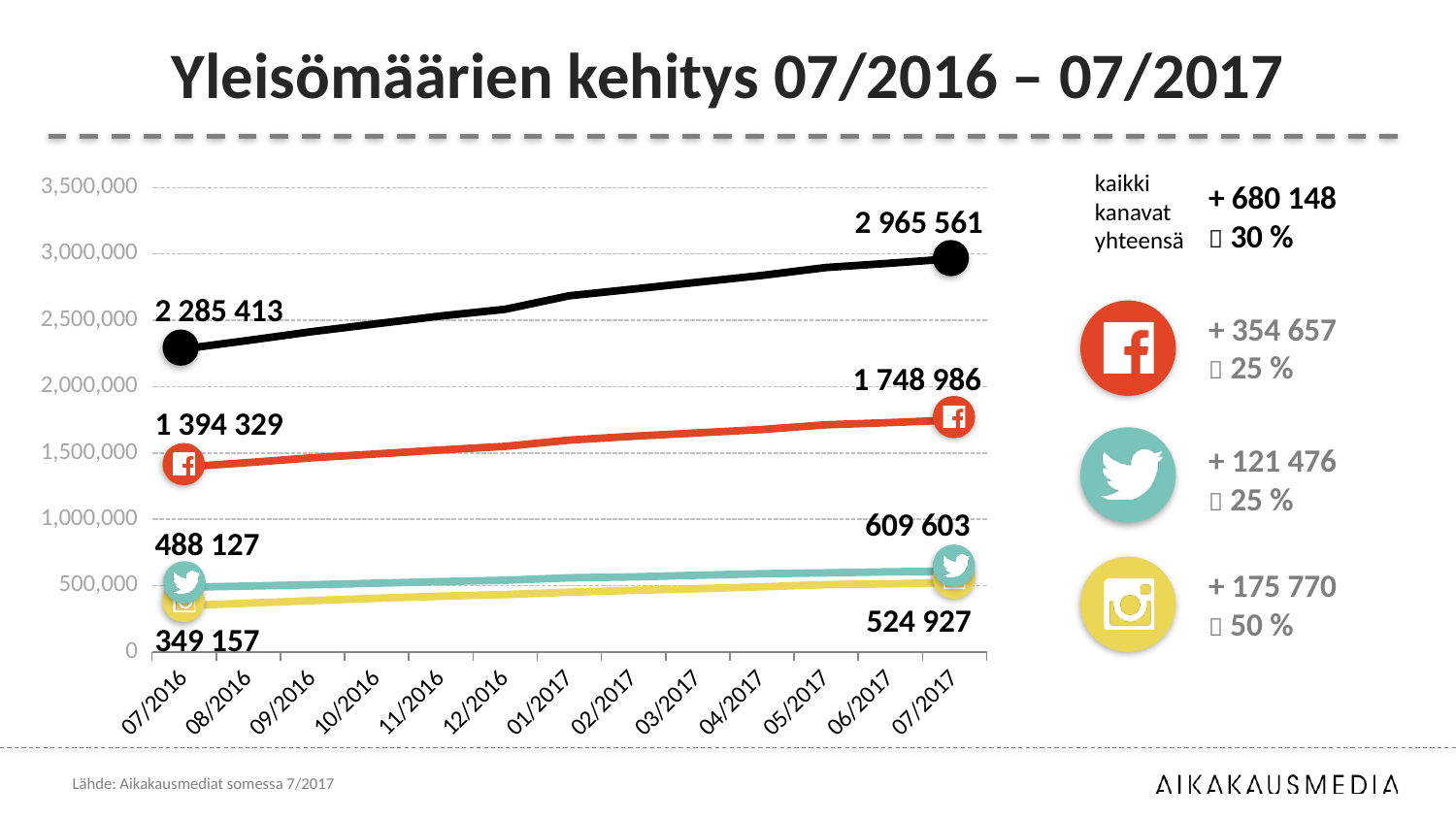
By how much did the Facebook value increase from 07/2016 to 07/2017? 354 657 What is the Facebook value at 07/2017? 1 748 986 What is the Twitter value at 07/2017? 609 603 How many months are shown on the x axis? 13 What is the value of the black (total) line at 07/2017? 2 965 561 What is the Facebook value at 07/2016? 1 394 329 What is the value of the black (total) line at 07/2016? 2 285 413 Does the Facebook line rise or fall from 07/2016 to 07/2017? rise What type of chart is shown on the slide? line chart Which line has the lowest value at 07/2016? Instagram (349 157) What is the Instagram value at 07/2016? 349 157 By how much did the Instagram value increase from 07/2016 to 07/2017? 175 770